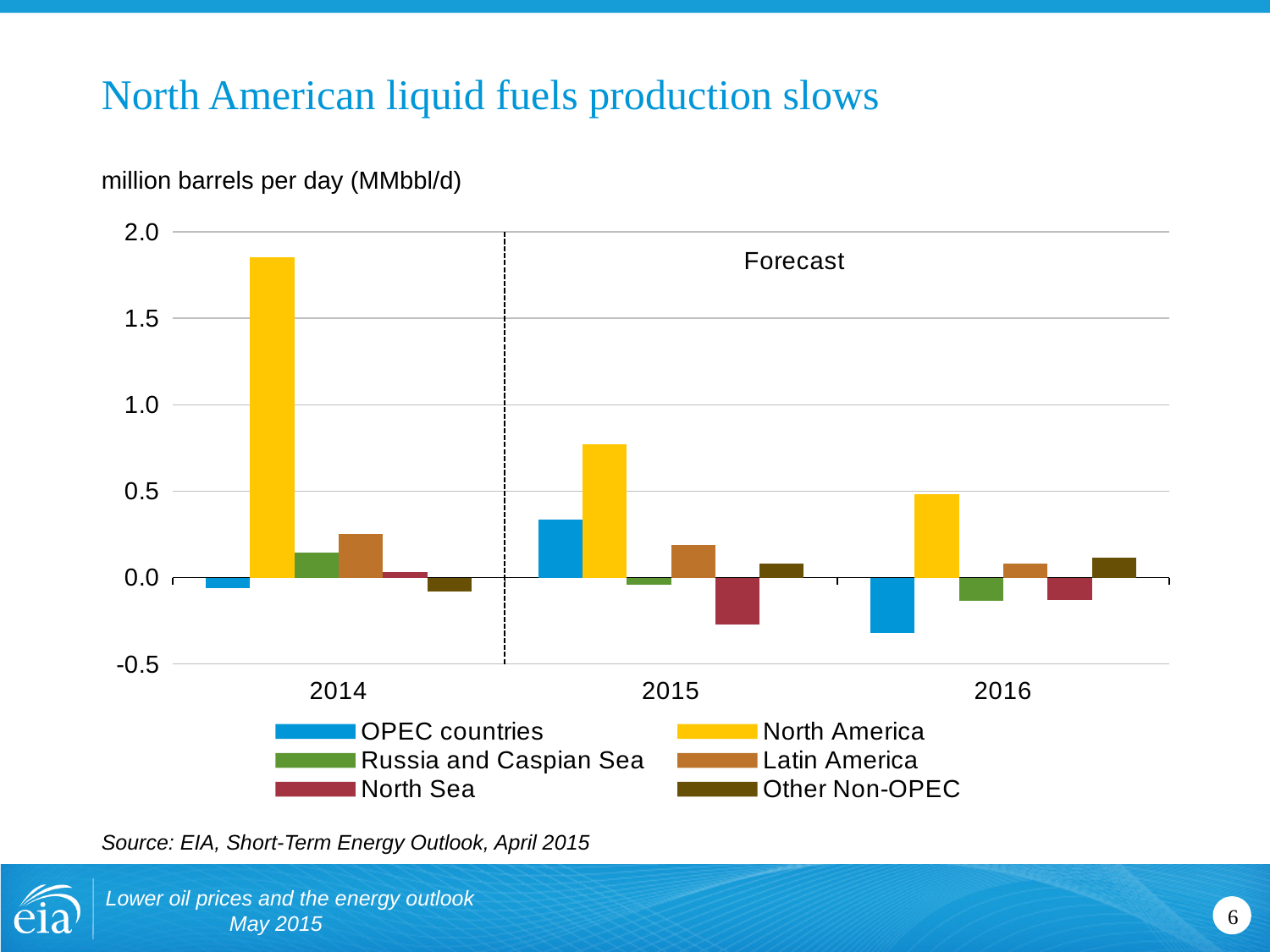
Which series has the lowest bar in 2016? OPEC countries In 2015, which is larger: the value for OPEC countries or the value for North America? North America What kind of chart is shown on the slide? bar chart Is the value for North America in 2015 greater or less than 0.5? greater Is the value for North America in 2014 greater or less than 1.5? greater Does the North America value rise or fall from 2014 to 2016? fall Is the value for OPEC countries in 2016 greater or less than 0.0? less How many years are shown on the x axis of the chart? 3 How many series does the chart's legend list? 6 Which series has the lowest bar in 2015? North Sea What unit is given above the chart? million barrels per day (MMbbl/d) Which series has the highest bar in 2014? North America